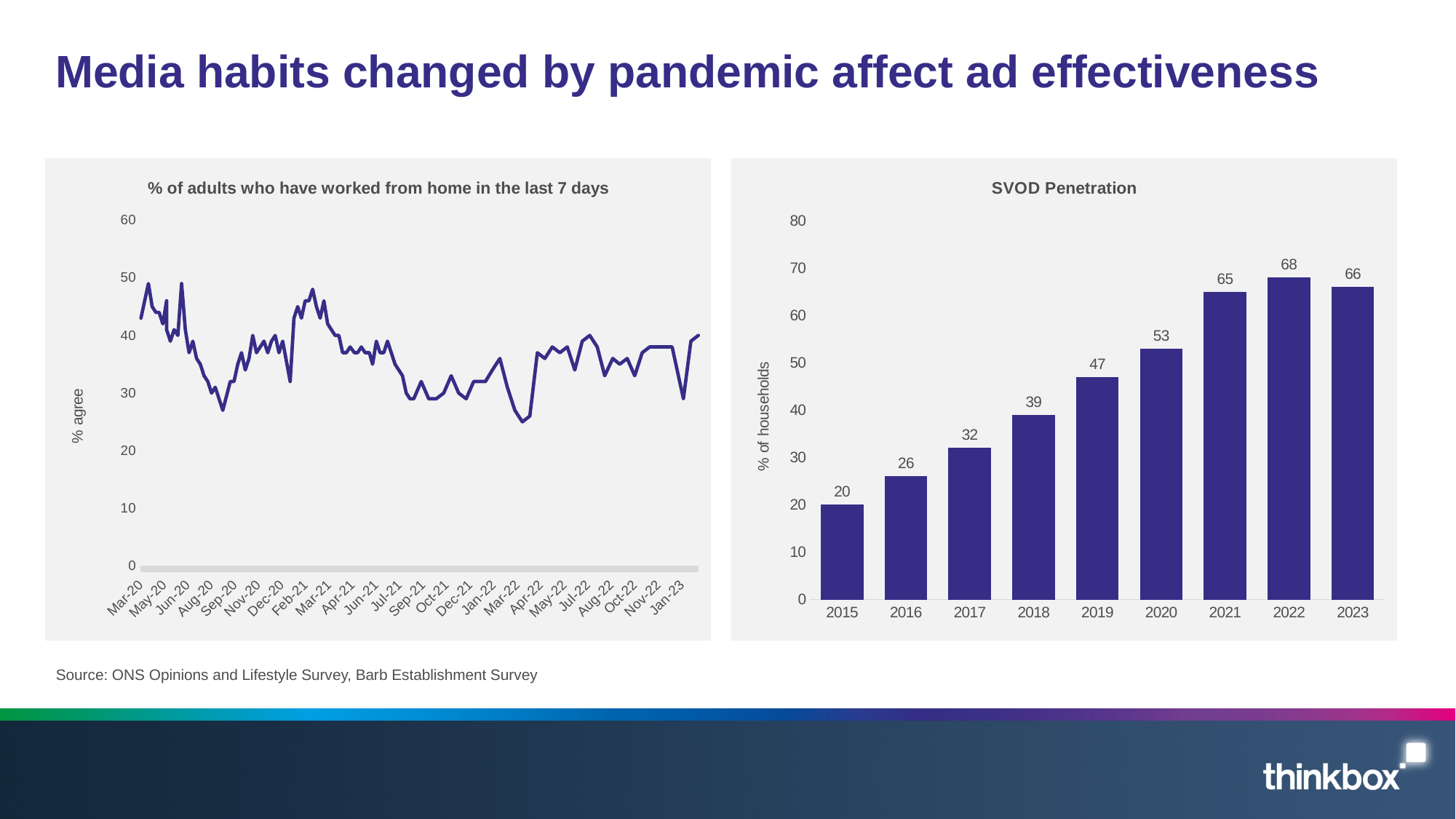
What is the y-axis label of the SVOD Penetration chart? % of households In the SVOD Penetration chart, what is the value for 2015? 20 What kind of chart is the SVOD Penetration chart? Bar chart What kind of chart is the '% of adults who have worked from home in the last 7 days' chart? Line chart In the SVOD Penetration chart, do the values rise or fall from 2015 to 2022? Rise In the SVOD Penetration chart, what is the value for 2019? 47 In the SVOD Penetration chart, which is larger, the value for 2021 or the value for 2023? 2023 In the '% of adults who have worked from home in the last 7 days' chart, is the value at Mar-22 greater or less than 30? less In the SVOD Penetration chart, which year has the lowest value? 2015 In the SVOD Penetration chart, how many years are shown on the x axis? 9 In the SVOD Penetration chart, what is the difference between the values for 2020 and 2017? 21 In the SVOD Penetration chart, which year has the highest value? 2022